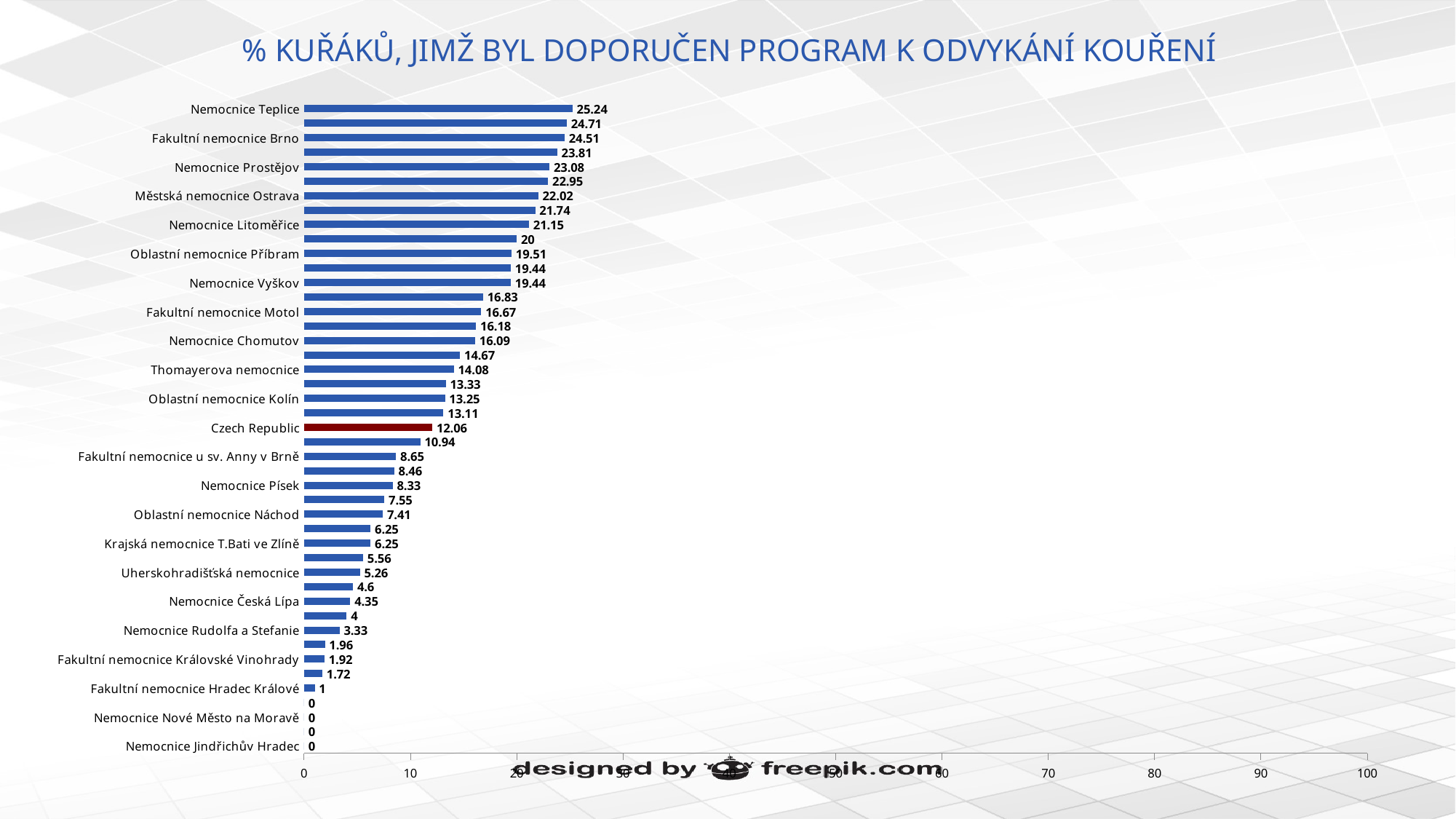
Is the value for Nemocnice Litoměřice greater or less than 20? greater What is the difference between Fakultní nemocnice Brno and Fakultní nemocnice Motol? 7.84 Which is larger, Nemocnice Prostějov or Městská nemocnice Ostrava? Nemocnice Prostějov Which hospital has the highest value? Nemocnice Teplice What kind of chart is shown on the slide? bar chart What is the value for Czech Republic? 12.06 What is the value for Nemocnice Jindřichův Hradec? 0 What is the value for Nemocnice Teplice? 25.24 What is the value for Fakultní nemocnice Hradec Králové? 1 What is the difference between Nemocnice Teplice and Czech Republic? 13.18 Which category's bar is coloured dark red instead of blue? Czech Republic What is the value for Fakultní nemocnice Motol? 16.67